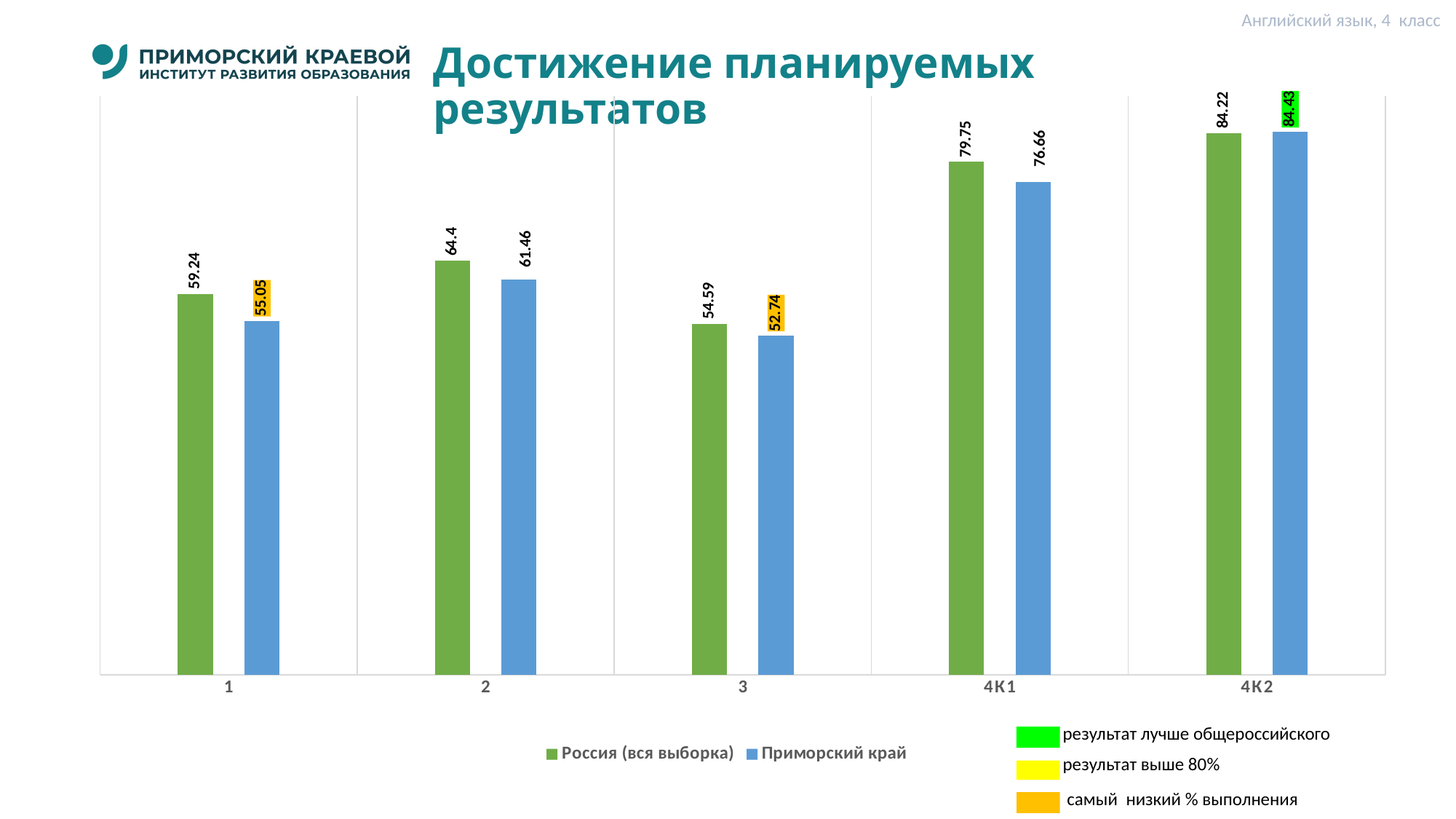
How many categories are shown on the x axis? 5 What is the value for Приморский край in category 4К2? 84.43 What is the value for Россия (вся выборка) in category 2? 64.4 What is the value for Приморский край in category 1? 55.05 How many series does the legend list? 2 What kind of chart is shown on the slide? bar chart In category 2, which series has the larger value: Россия (вся выборка) or Приморский край? Россия (вся выборка) What is the difference between Россия (вся выборка) and Приморский край in category 1? 4.19 What is the value for Россия (вся выборка) in category 4К1? 79.75 Which category has the highest value for Россия (вся выборка)? 4К2 What is the difference between Россия (вся выборка) and Приморский край in category 4К1? 3.09 Which category has the lowest value for Приморский край? 3